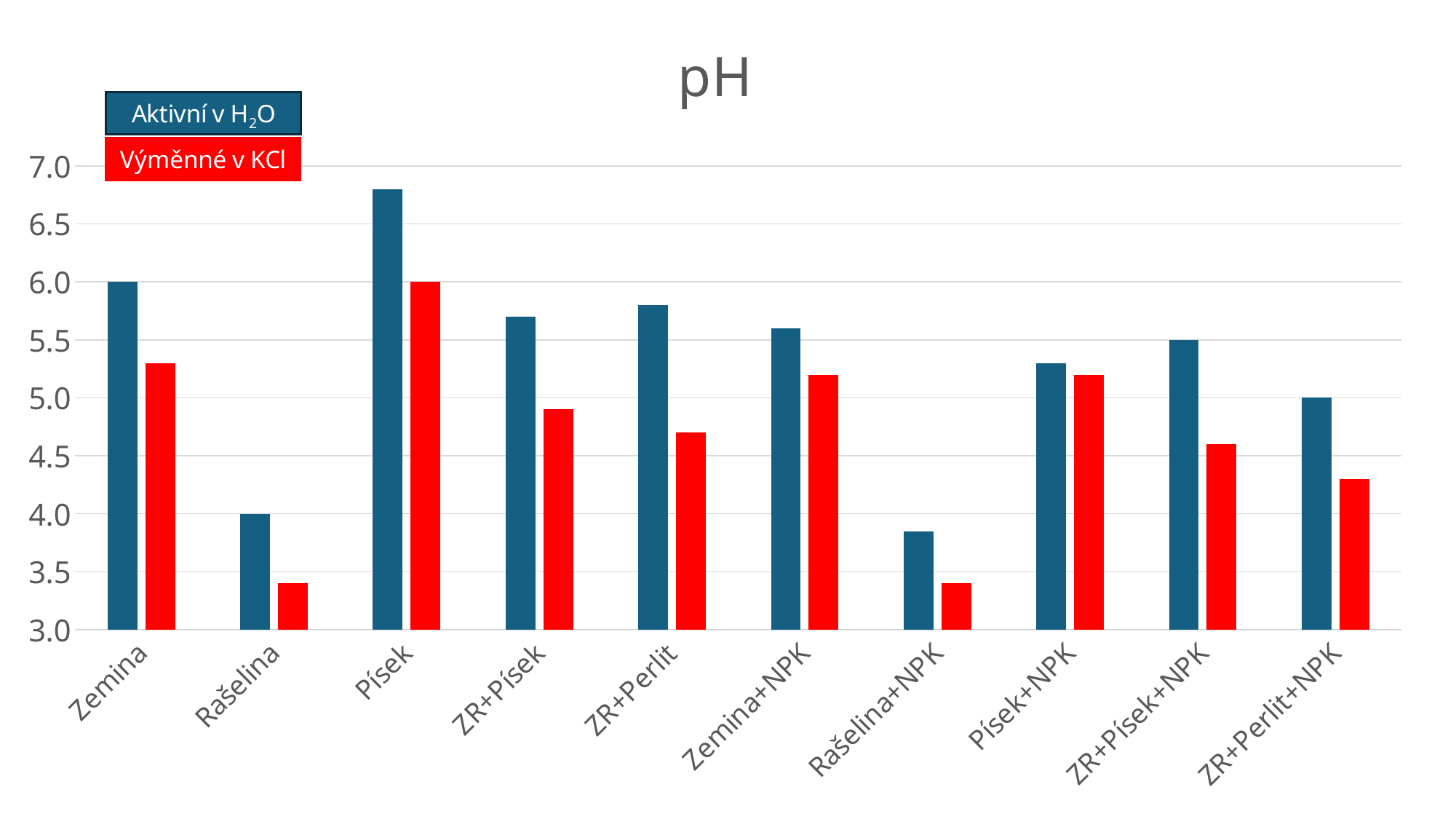
What is the Aktivní v H2O value for Rašelina? 4.0 Is the Aktivní v H2O value for Písek greater or less than 6.5? greater How many categories are shown on the x axis? 10 What kind of chart is shown on the slide? bar chart Is the Výměnné v KCl value for ZR+Perlit greater or less than 5.0? less What is the Výměnné v KCl value for Písek? 6.0 What is the Aktivní v H2O value for Zemina? 6.0 How many series does the legend list? 2 What is the title of the chart? pH Which series is drawn in red? Výměnné v KCl Which category has the highest Aktivní v H2O value? Písek Which category has the highest Výměnné v KCl value? Písek